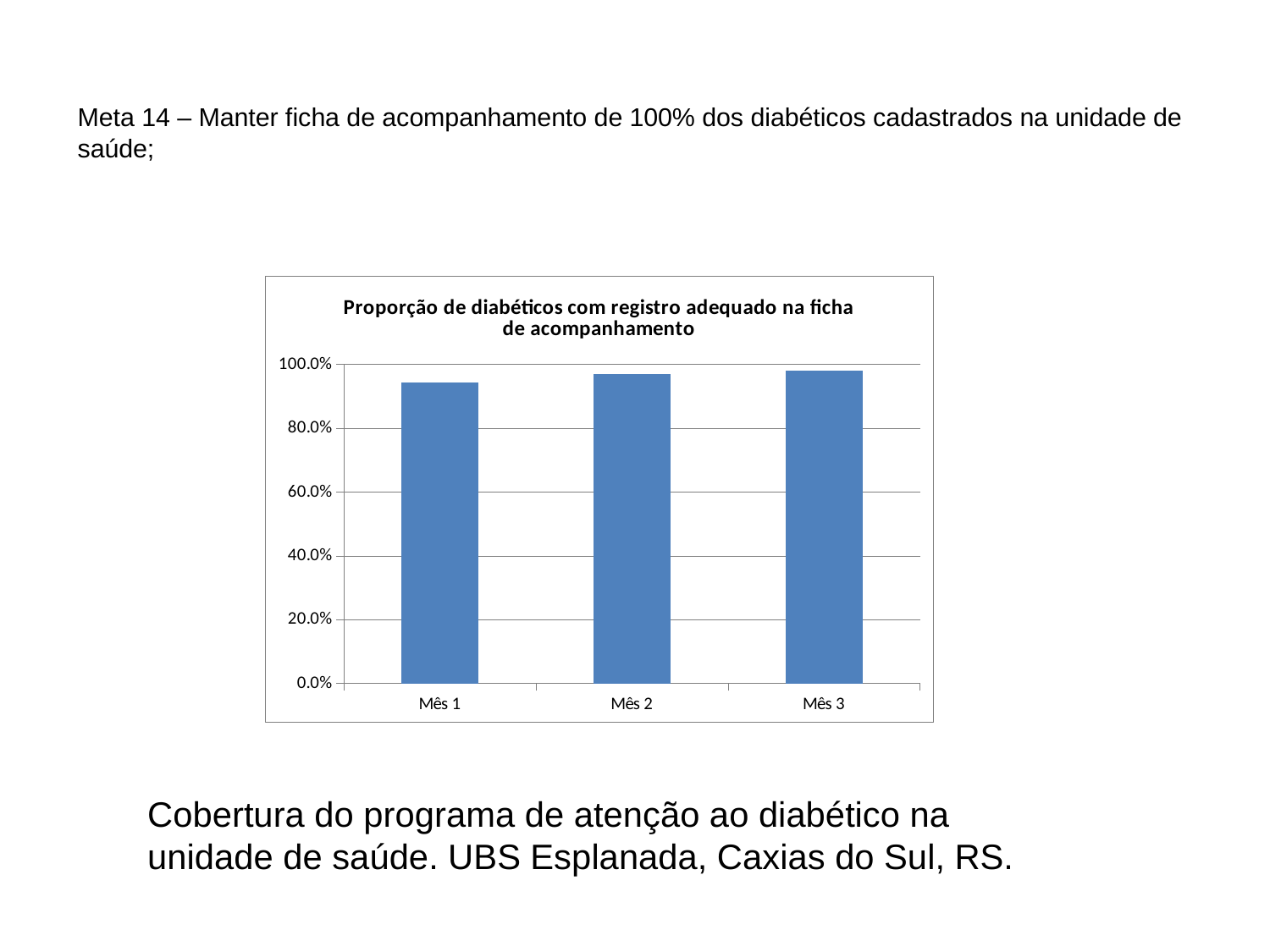
What kind of chart is shown on the slide? bar chart How many categories (months) are plotted on the chart? 3 What is the title of the chart? Proporção de diabéticos com registro adequado na ficha de acompanhamento Which is larger, the value for Mês 1 or the value for Mês 2? Mês 2 What is the highest value shown on the vertical axis of the chart? 100.0% Which is larger, the value for Mês 1 or the value for Mês 3? Mês 3 Which month has the lowest proportion of diabetics with adequate records? Mês 1 Do the values rise or fall from Mês 1 to Mês 3? rise Is the value for Mês 1 greater or less than 80.0%? greater Is the value for Mês 3 greater or less than 100.0%? less Is the value for Mês 2 greater or less than 60.0%? greater